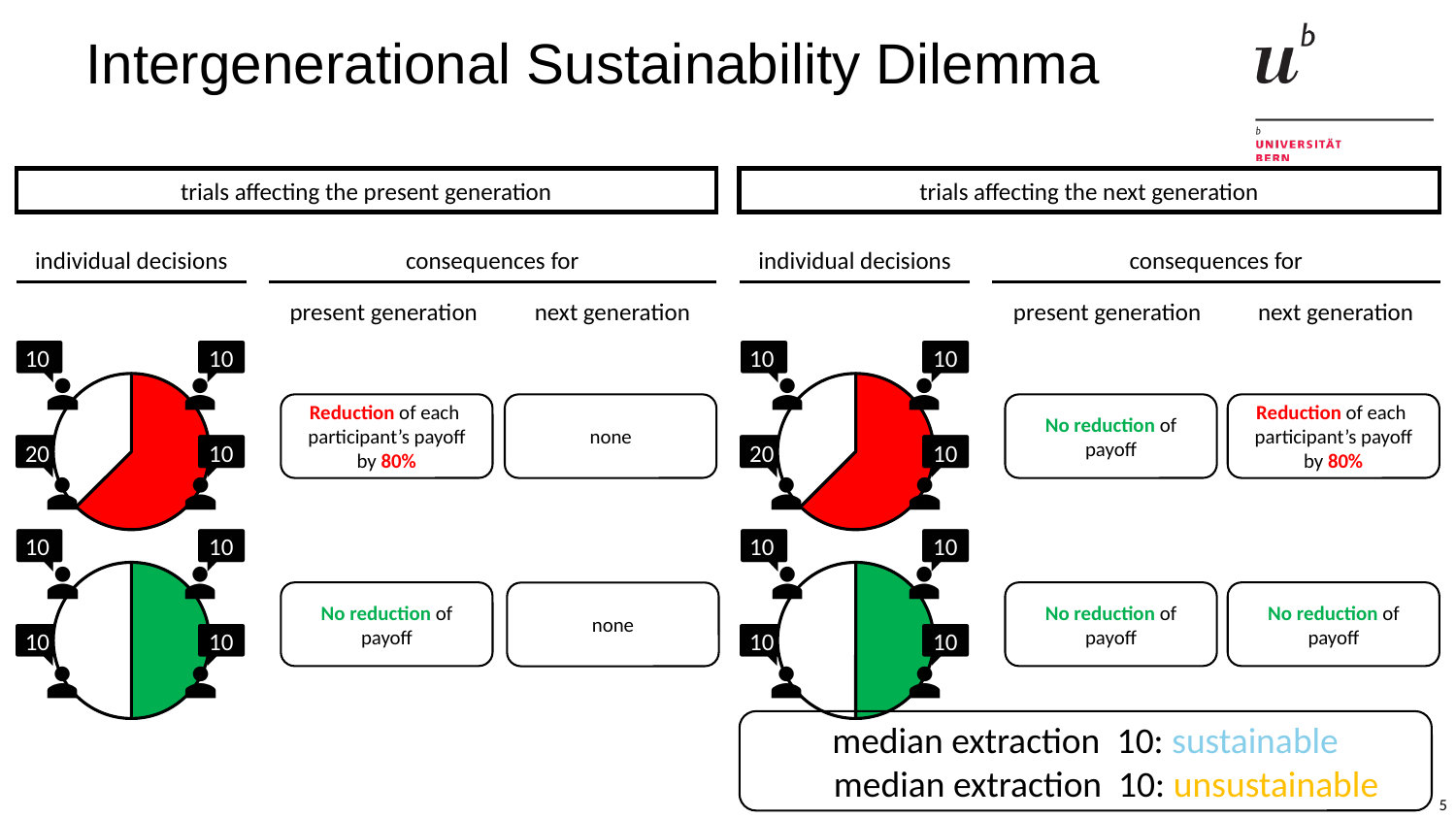
In the top-right pie diagram (trials affecting the next generation), how many participants chose 20? 1 In the top-left pie diagram (trials affecting the present generation), what is the highest individual decision value shown? 20 How many pie diagrams are shown on the slide? 4 In the bottom-left pie diagram, what is the total of the four individual decision values? 40 In the bottom-right pie diagram, what value did each of the four participants choose? 10 In the top-left pie diagram, what is the lowest individual decision value shown? 10 What colour is the filled portion of the pie diagrams in the bottom row? green In the top-left pie diagram, what is the total of the four individual decision values? 50 What kind of chart is used to show the individual decisions on this slide? pie chart What is the difference between the total individual decisions in the top-left pie diagram and the bottom-left pie diagram? 10 Which pie diagram has the larger filled portion: the top-left (red) or the bottom-left (green)? top-left (red) What colour is the filled portion of the pie diagrams in the top row? red